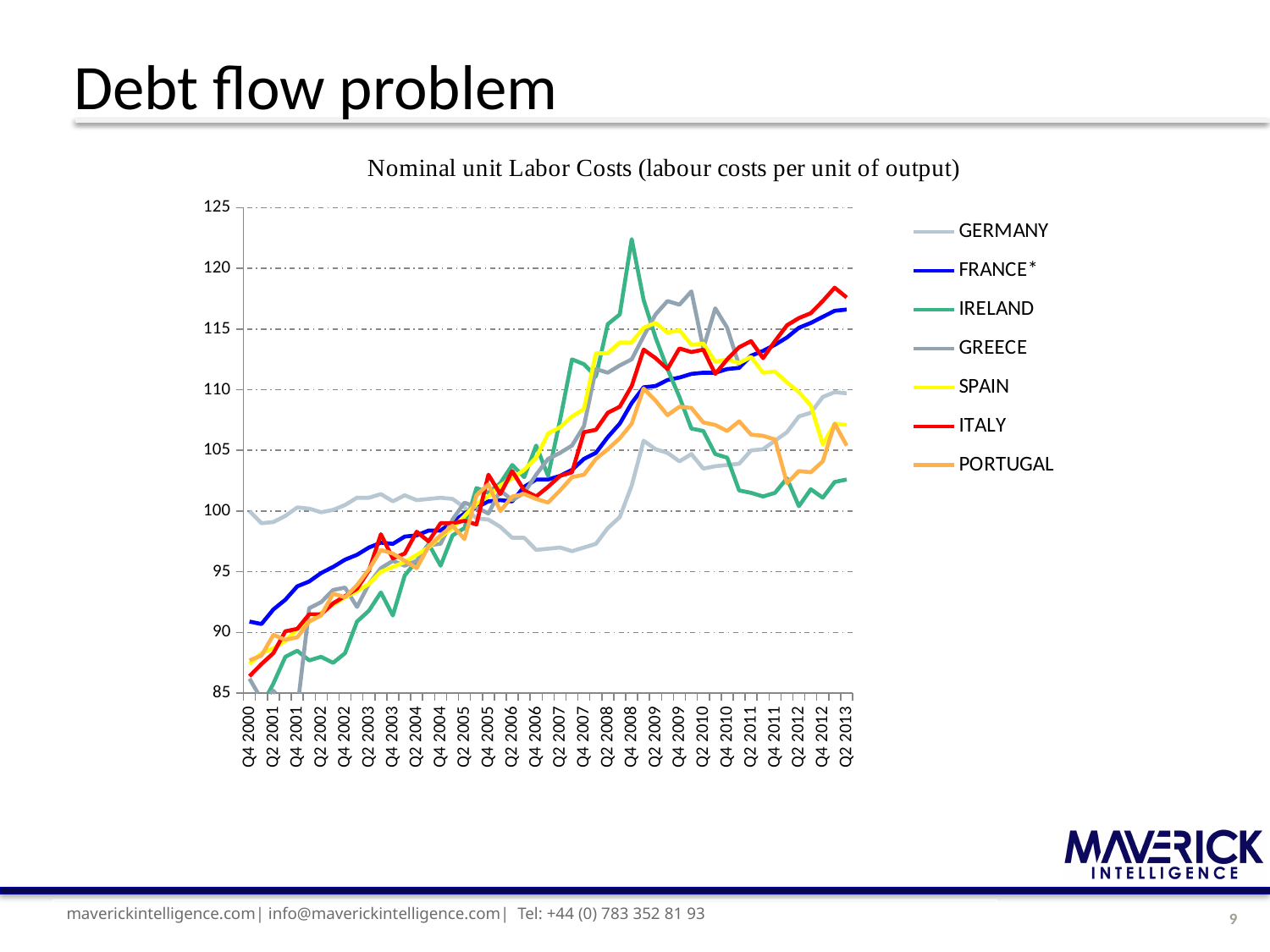
What kind of chart is shown on the slide? Line chart At Q2 2013, which is higher, ITALY or IRELAND? ITALY Which series reaches the highest value anywhere on the chart? IRELAND Is the value for ITALY at Q2 2013 greater or less than 115? greater Which series is drawn in red? ITALY Is the peak value for IRELAND around Q4 2008 greater or less than 120? greater Is the value for GREECE at Q4 2009 greater or less than 115? greater What is the title of the chart? Nominal unit Labor Costs (labour costs per unit of output) At Q4 2008, which is higher, IRELAND or GERMANY? IRELAND How many series does the legend list? 7 Does the FRANCE* series generally rise or fall from Q4 2000 to Q2 2013? rise